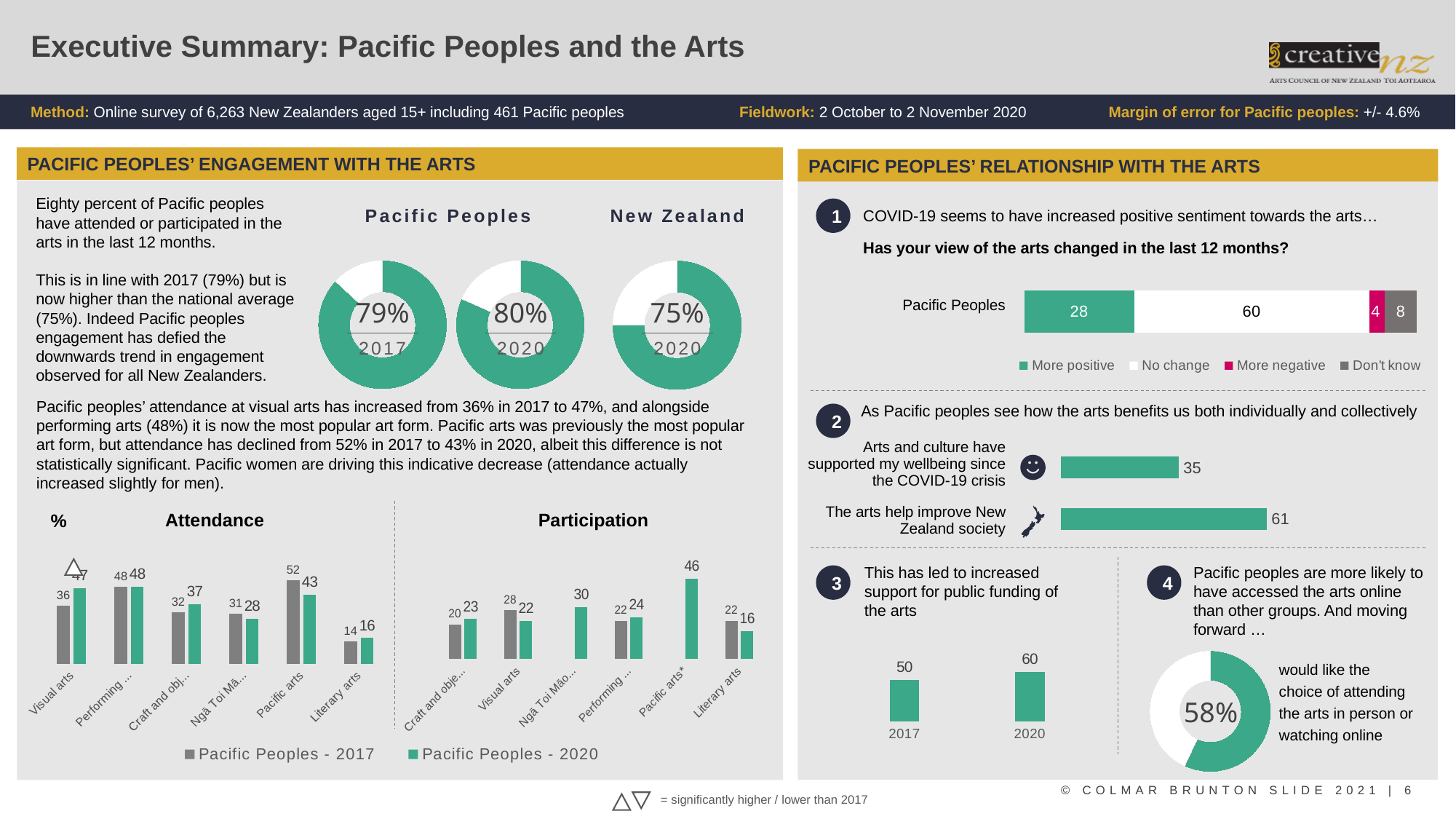
In the chart showing support for public funding of the arts, what is the value for 2020? 60 How many series does the legend of the Attendance chart list? 2 In the Participation chart, what is the Pacific Peoples - 2020 value for Pacific arts*? 46 In the Attendance chart, which category has the lowest Pacific Peoples - 2020 value? Literary arts In the 'Has your view of the arts changed in the last 12 months?' chart, what is the total of the stacked bar for Pacific Peoples? 100 In the Attendance chart, which category has the highest Pacific Peoples - 2017 value? Pacific arts In the Attendance chart, what is the difference between the 2017 and 2020 values for Pacific arts? 9 What percentage is shown in the New Zealand 2020 donut chart? 75% In the Participation chart, which is larger for Visual arts: the 2017 value or the 2020 value? 2017 In the Attendance chart, what is the Pacific Peoples - 2017 value for Visual arts? 36 In the Attendance chart, what is the Pacific Peoples - 2020 value for Pacific arts? 43 In the 'Has your view of the arts changed in the last 12 months?' chart, what is the value for 'No change'? 60